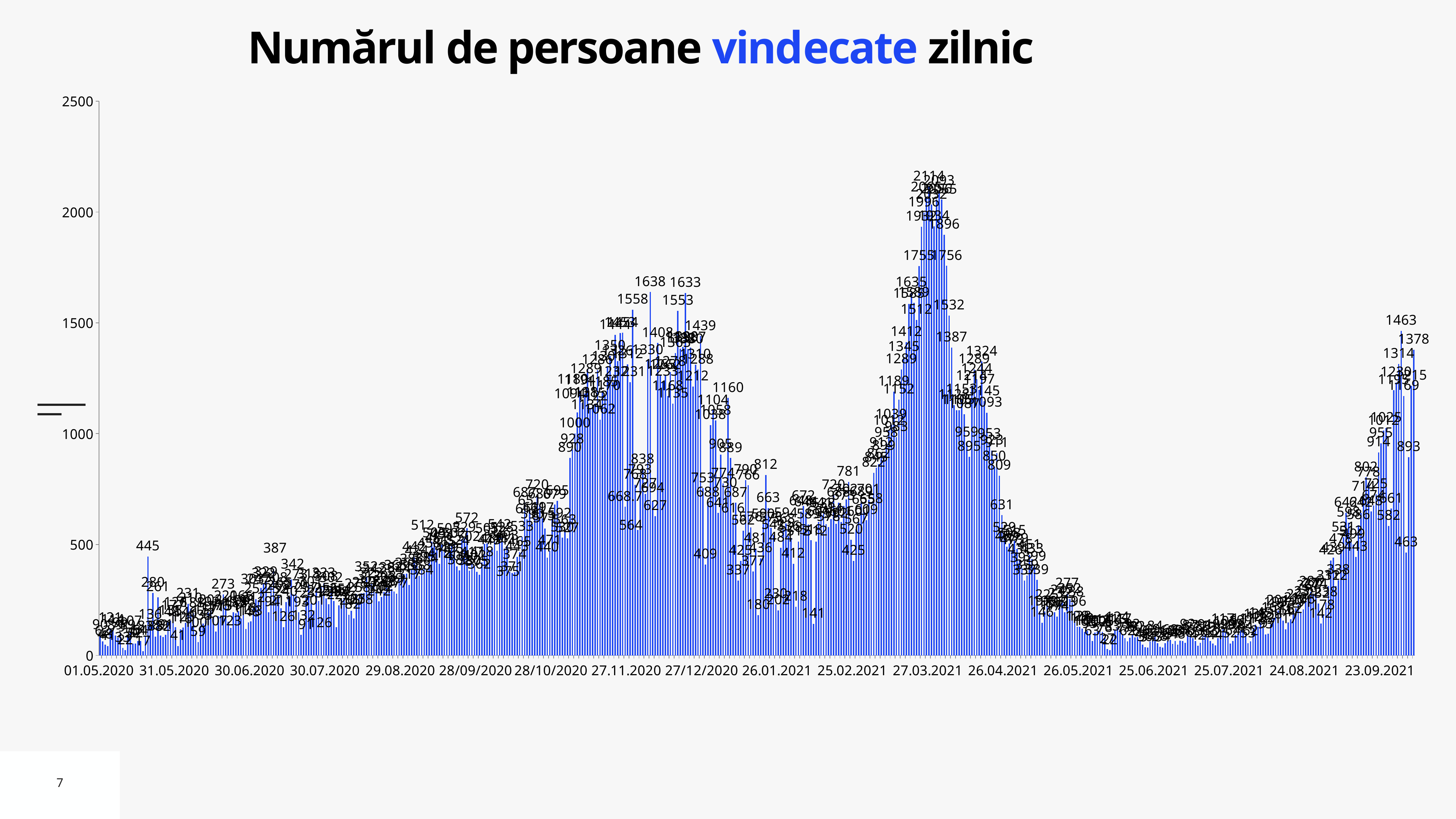
Is the value for the first bar, at 01.05.2020, greater or less than 500? less Around which x-axis date does the chart reach its highest peak? 27.03.2021 Do the values rise or fall along the x axis between 26.04.2021 and 25.06.2021? fall What kind of chart is shown on the slide? bar chart What is the difference between the highest label on the chart (2114) and the highest label near 27.11.2020 (1638)? 476 Which peak is larger: the one near 27.03.2021 or the one near 27.11.2020? the one near 27.03.2021 Do the values rise or fall along the x axis between 24.08.2021 and 23.09.2021? rise What is the highest data label shown on the chart? 2114 Is the highest peak of the chart, near 27.03.2021, greater or less than 2000? greater What is the value of the tallest bar in May 2020, labeled just before 31.05.2020? 445 What is the title of the chart? Numărul de persoane vindecate zilnic What is the maximum value shown on the y axis? 2500